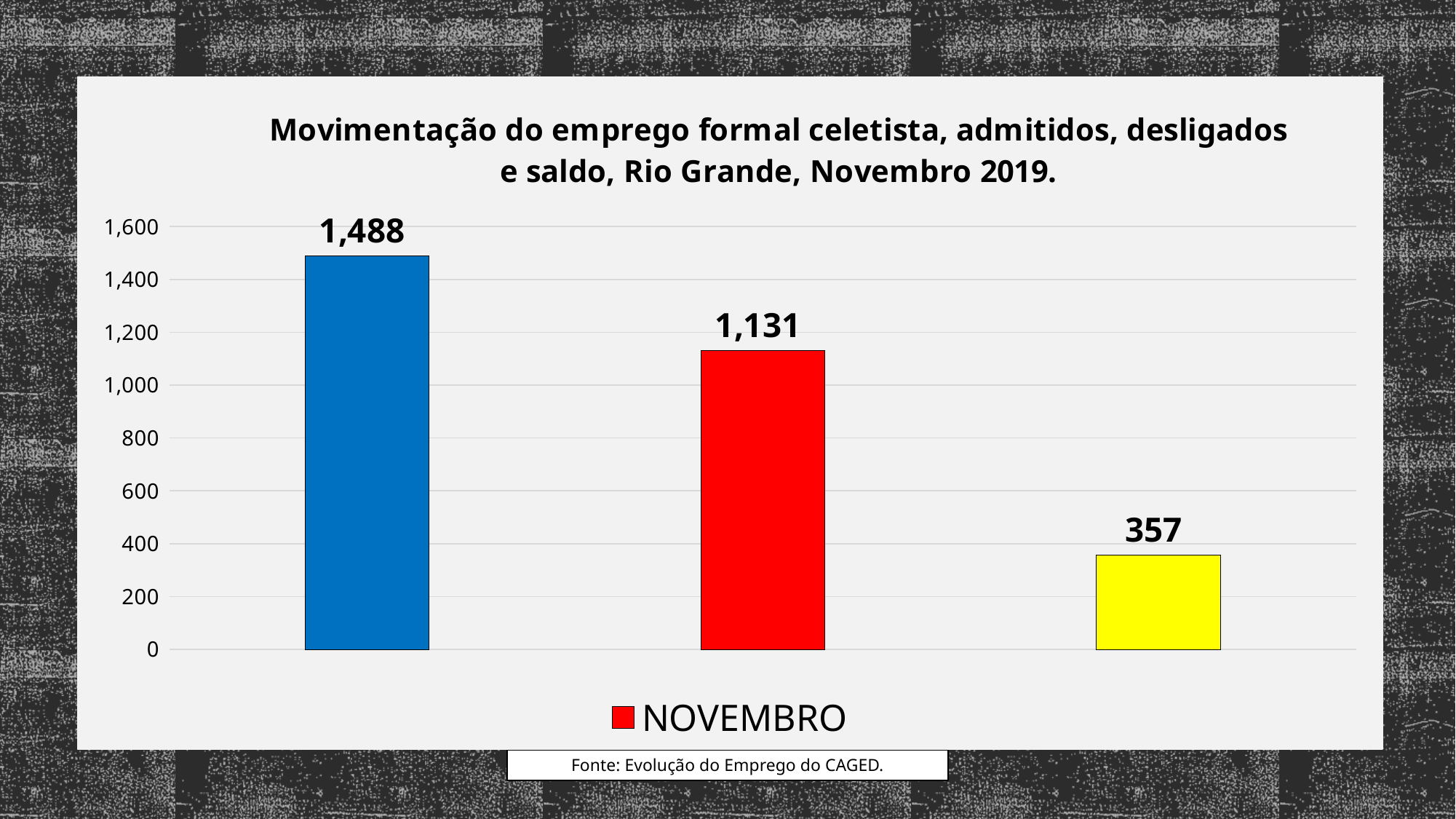
What is the value shown on the red bar (the middle bar)? 1,131 Which bar has the lowest value: the blue, red or yellow one? yellow Is the value of the yellow bar greater or less than 400? less What kind of chart is shown on the slide? bar chart How many series does the legend list? 1 What is the difference between the value of the red bar and the value of the yellow bar? 774 What is the difference between the value of the blue bar and the value of the red bar? 357 What is the value shown on the yellow bar (the rightmost bar)? 357 Which bar has the highest value: the blue, red or yellow one? blue What is the value shown on the blue bar (the first bar from the left)? 1,488 Which is larger, the value of the red bar or the value of the yellow bar? the red bar How many bars are plotted in the chart? 3